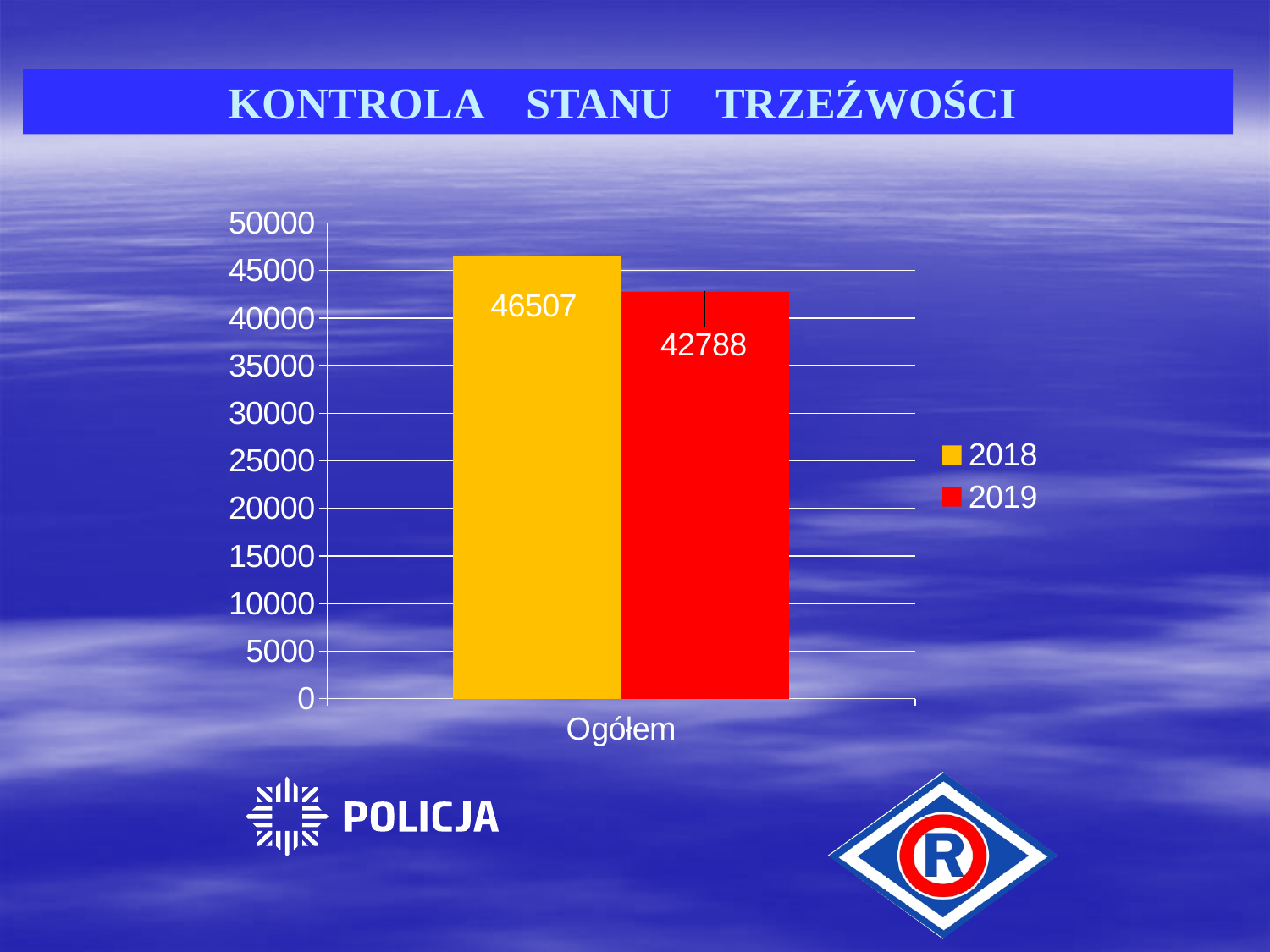
Which series has the lowest value on the chart? 2019 Which series has the higher value for Ogółem, 2018 or 2019? 2018 What kind of chart is shown on the slide? bar chart What is the value for 2018 in the Ogółem category? 46507 Is the value for 2019 greater or less than 45000? less What is the title of the slide above the chart? KONTROLA STANU TRZEŹWOŚCI What is the value for 2019 in the Ogółem category? 42788 How many categories are shown on the x axis? 1 What is the difference between the 2018 and 2019 values for Ogółem? 3719 How many series does the legend list? 2 What colour represents the 2019 series in the chart? red Is the value for 2018 greater or less than 45000? greater